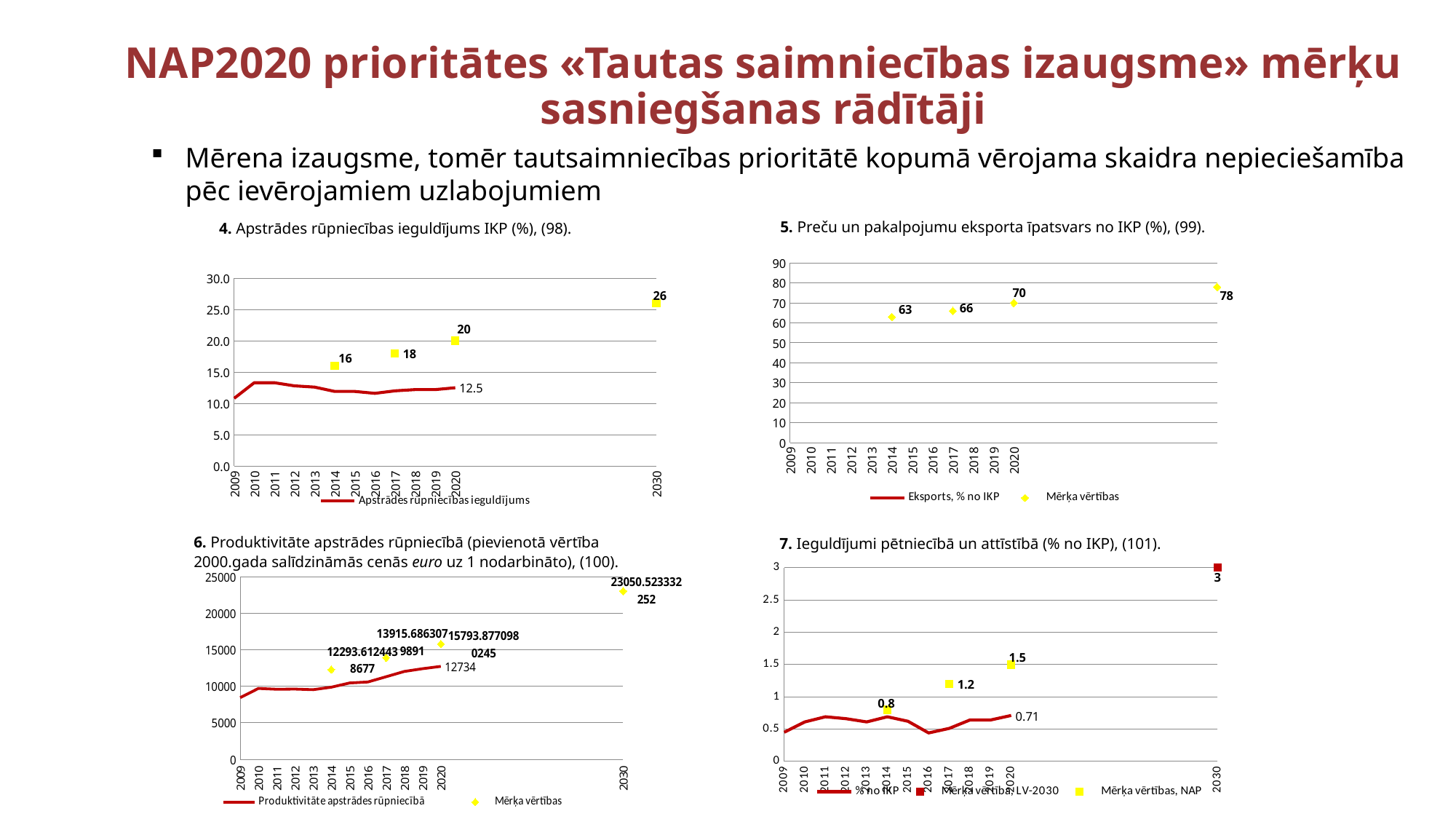
In chart 4 (Apstrādes rūpniecības ieguldījums IKP), what value does the red line show for 2020? 12.5 In chart 5 (Preču un pakalpojumu eksporta īpatsvars no IKP), which year has the highest target value? 2030 In chart 7 (Ieguldījumi pētniecībā un attīstībā), how many series does the legend list? 3 In chart 4 (Apstrādes rūpniecības ieguldījums IKP), what is the difference between the 2020 target value (20) and the actual 2020 value (12.5)? 7.5 In chart 5 (Preču un pakalpojumu eksporta īpatsvars no IKP), what is the target value for 2014? 63 In chart 7 (Ieguldījumi pētniecībā un attīstībā), what value does the red line show for 2020? 0.71 In chart 5 (Preču un pakalpojumu eksporta īpatsvars no IKP), what is the target value for 2030? 78 In chart 6 (Produktivitāte apstrādes rūpniecībā), what value does the red line show for 2020? 12734 In chart 4 (Apstrādes rūpniecības ieguldījums IKP), what is the target value shown for 2030? 26 In chart 7 (Ieguldījumi pētniecībā un attīstībā), what is the target value shown for 2030? 3 In chart 5 (Preču un pakalpojumu eksporta īpatsvars no IKP), what is the difference between the 2030 target (78) and the 2020 target (70)? 8 In chart 4 (Apstrādes rūpniecības ieguldījums IKP), is the value of the red line in 2010 greater or less than 10.0? greater